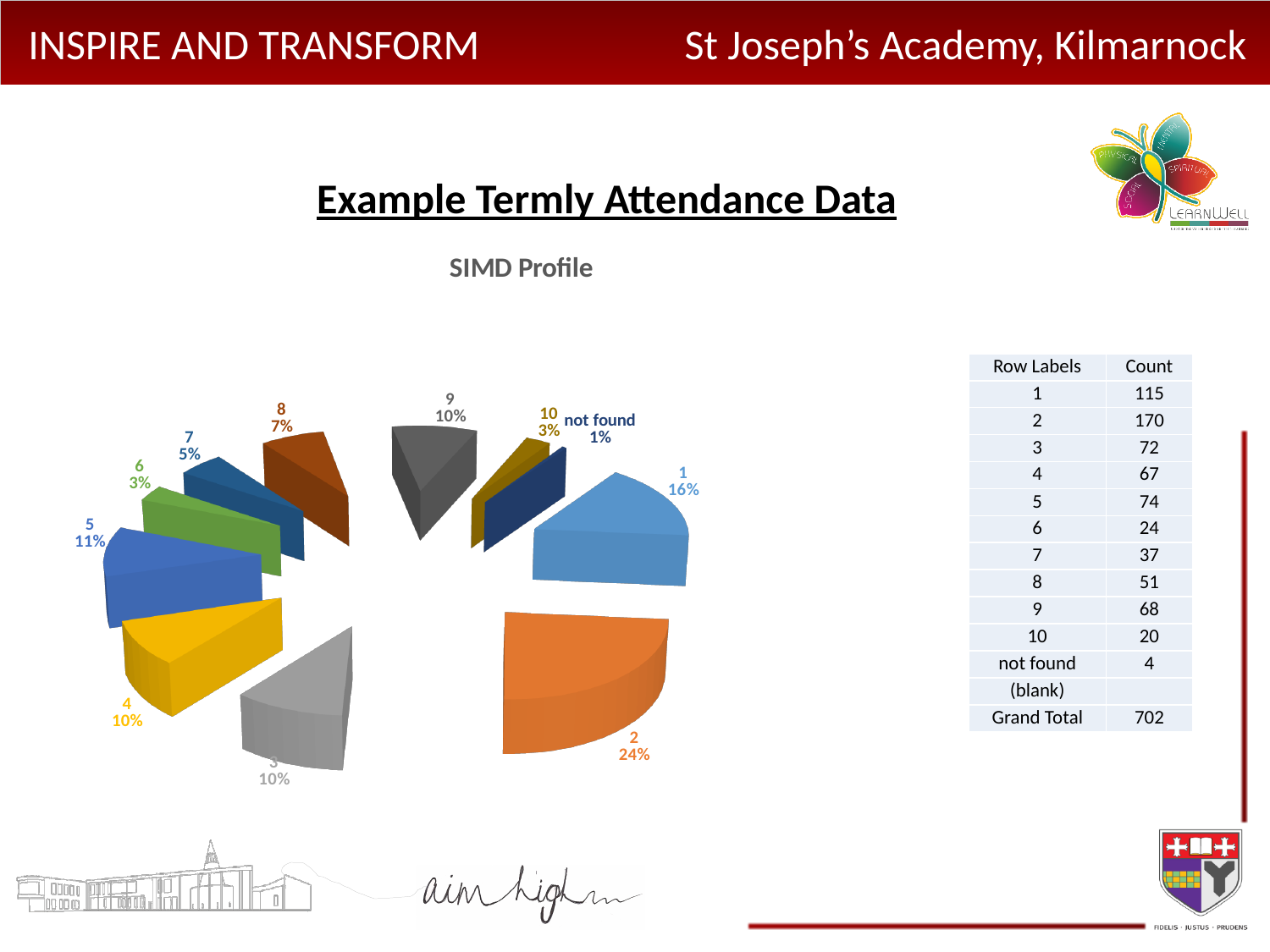
What percentage of the pie does category 2 represent? 24% Which slice of the pie is the smallest? not found How many slices does the pie chart have? 11 What percentage is shown for category 10 in the pie chart? 3% Which has a larger share of the pie, category 8 or category 7? 8 Which category has the largest slice of the pie? 2 What kind of chart is shown on the slide? pie chart What percentage is shown for category 1 in the pie chart? 16% What percentage is shown for the 'not found' slice? 1% What percentage is shown for category 5 in the pie chart? 11% What is the difference in percentage points between category 2 and category 1? 8% What is the title of the chart? SIMD Profile